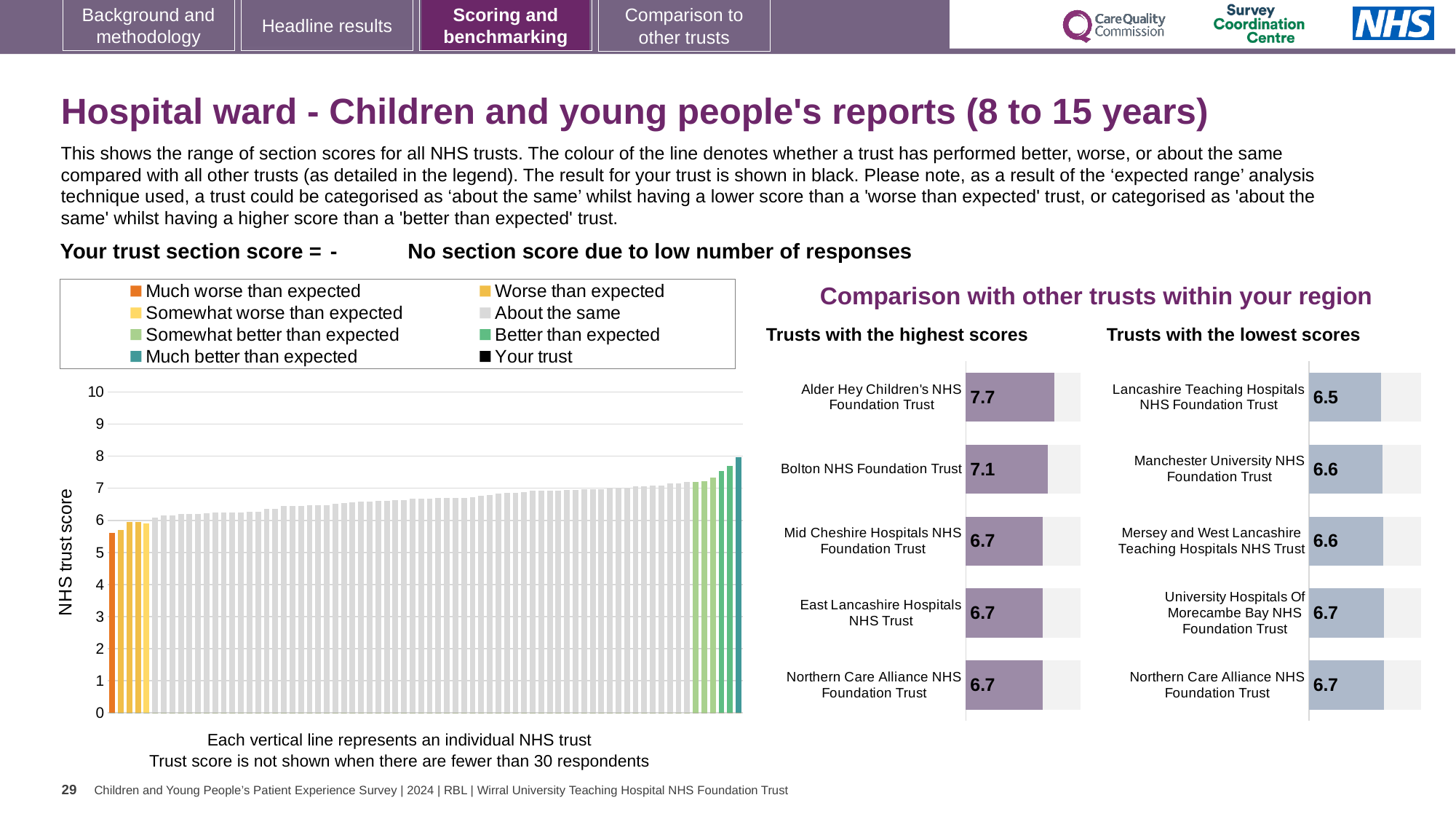
In the 'Trusts with the highest scores' chart, what is the difference between the scores of Alder Hey Children's NHS Foundation Trust and Bolton NHS Foundation Trust? 0.6 How many trusts are shown in the 'Trusts with the lowest scores' chart? 5 In the 'Trusts with the lowest scores' chart, what is the score for Manchester University NHS Foundation Trust? 6.6 In the 'Trusts with the highest scores' chart, which has the larger score: Bolton NHS Foundation Trust or Mid Cheshire Hospitals NHS Foundation Trust? Bolton NHS Foundation Trust In the 'Trusts with the lowest scores' chart, which trust has the lowest score? Lancashire Teaching Hospitals NHS Foundation Trust In the 'NHS trust score' chart on the left, do the bar values rise or fall from left to right? rise What kind of chart is the 'NHS trust score' chart on the left of the slide? bar chart In the 'Trusts with the lowest scores' chart, what is the score for Lancashire Teaching Hospitals NHS Foundation Trust? 6.5 In the 'Trusts with the highest scores' chart, what is the score for Alder Hey Children's NHS Foundation Trust? 7.7 In the 'NHS trust score' chart on the left, is the value of the tallest bar greater or less than 7? greater How many entries does the legend above the 'NHS trust score' chart list? 8 In the 'Trusts with the highest scores' chart, which trust has the highest score? Alder Hey Children's NHS Foundation Trust